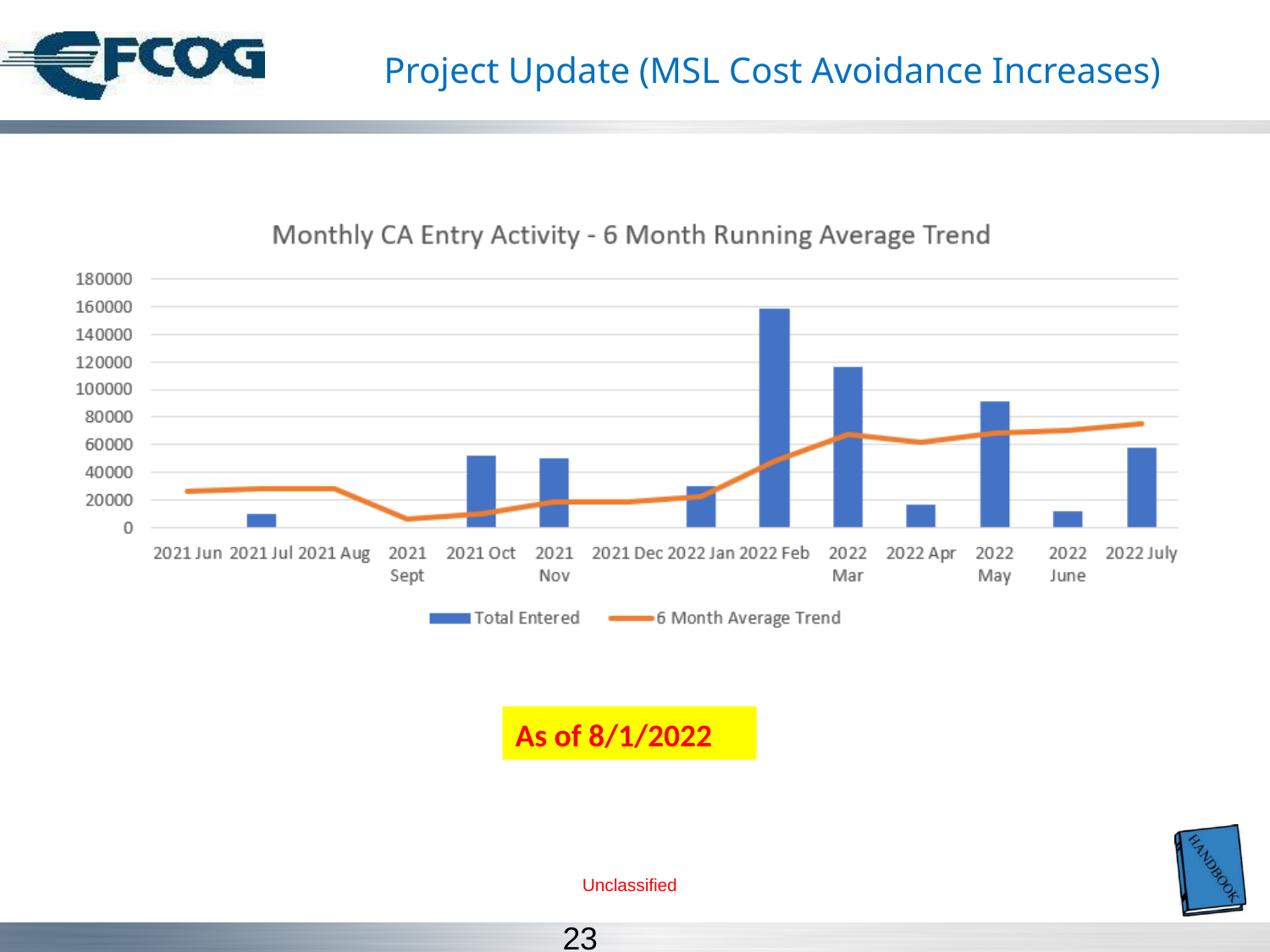
Is the 6 Month Average Trend value for 2022 July greater or less than 60000? greater How many series does the legend list? 2 How many months are shown along the x axis? 14 What are the two series named in the legend? Total Entered and 6 Month Average Trend Which month has the highest Total Entered bar? 2022 Feb Which is larger, the Total Entered bar for 2022 May or for 2022 June? 2022 May Is the Total Entered value for 2022 Mar greater or less than 100000? greater What is the title of the chart? Monthly CA Entry Activity - 6 Month Running Average Trend Does the 6 Month Average Trend line generally rise or fall from 2021 Sept to 2022 July? rise Is the Total Entered value for 2022 Apr greater or less than 40000? less What type of chart is shown on the slide? Combination bar and line chart